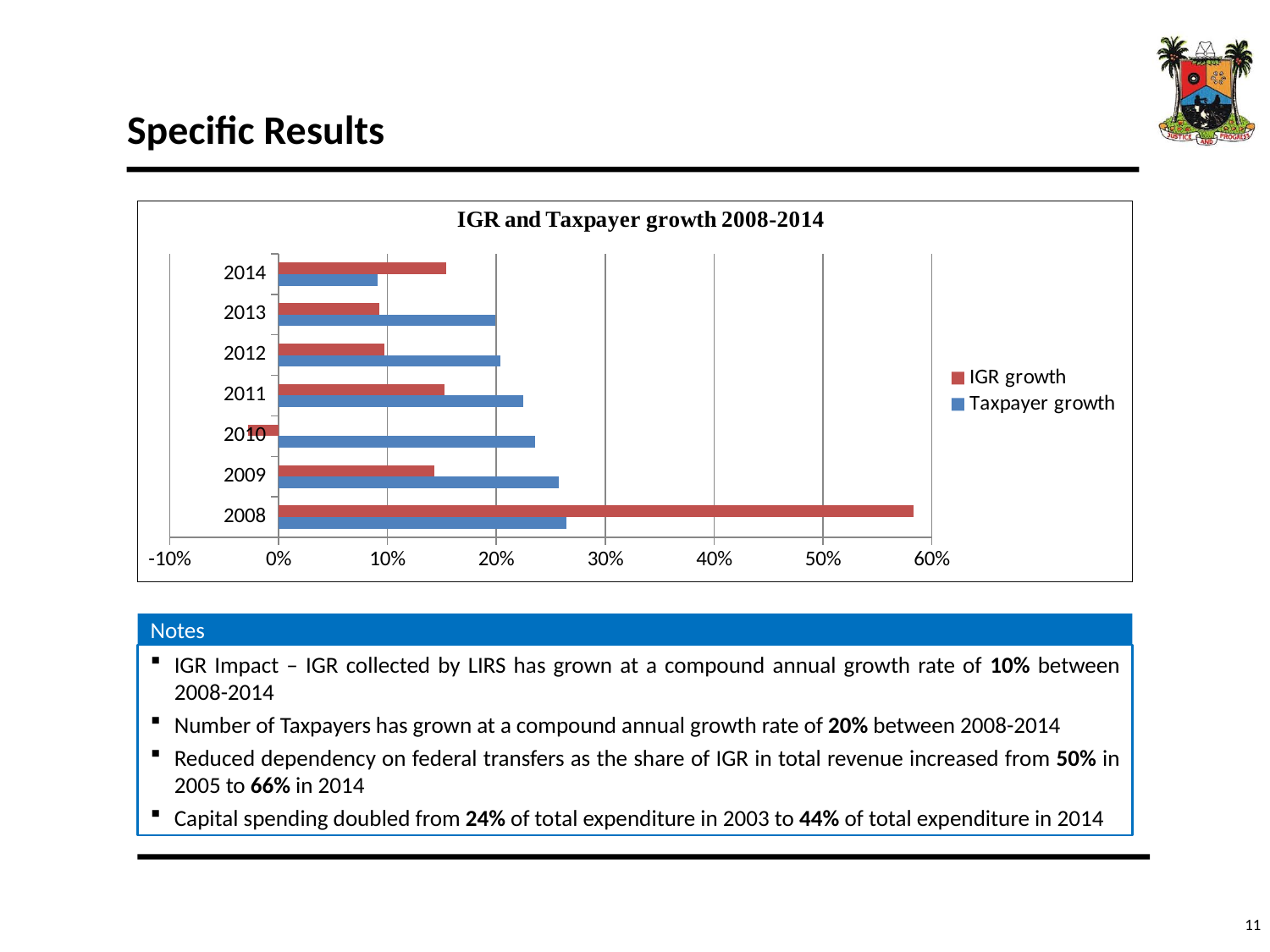
Is the IGR growth for 2008 greater or less than 50%? greater In 2011, which is larger: IGR growth or Taxpayer growth? Taxpayer growth Which year has the highest IGR growth? 2008 Is the IGR growth for 2010 greater or less than 0%? less Which year has the lowest IGR growth? 2010 Which year has the lowest Taxpayer growth? 2014 In 2014, which is larger: IGR growth or Taxpayer growth? IGR growth Is the Taxpayer growth for 2009 greater or less than 20%? greater How many years are shown on the y axis of the chart? 7 What is the title of the chart? IGR and Taxpayer growth 2008-2014 What kind of chart is shown on the slide? Bar chart How many series does the legend list in the IGR and Taxpayer growth chart? 2